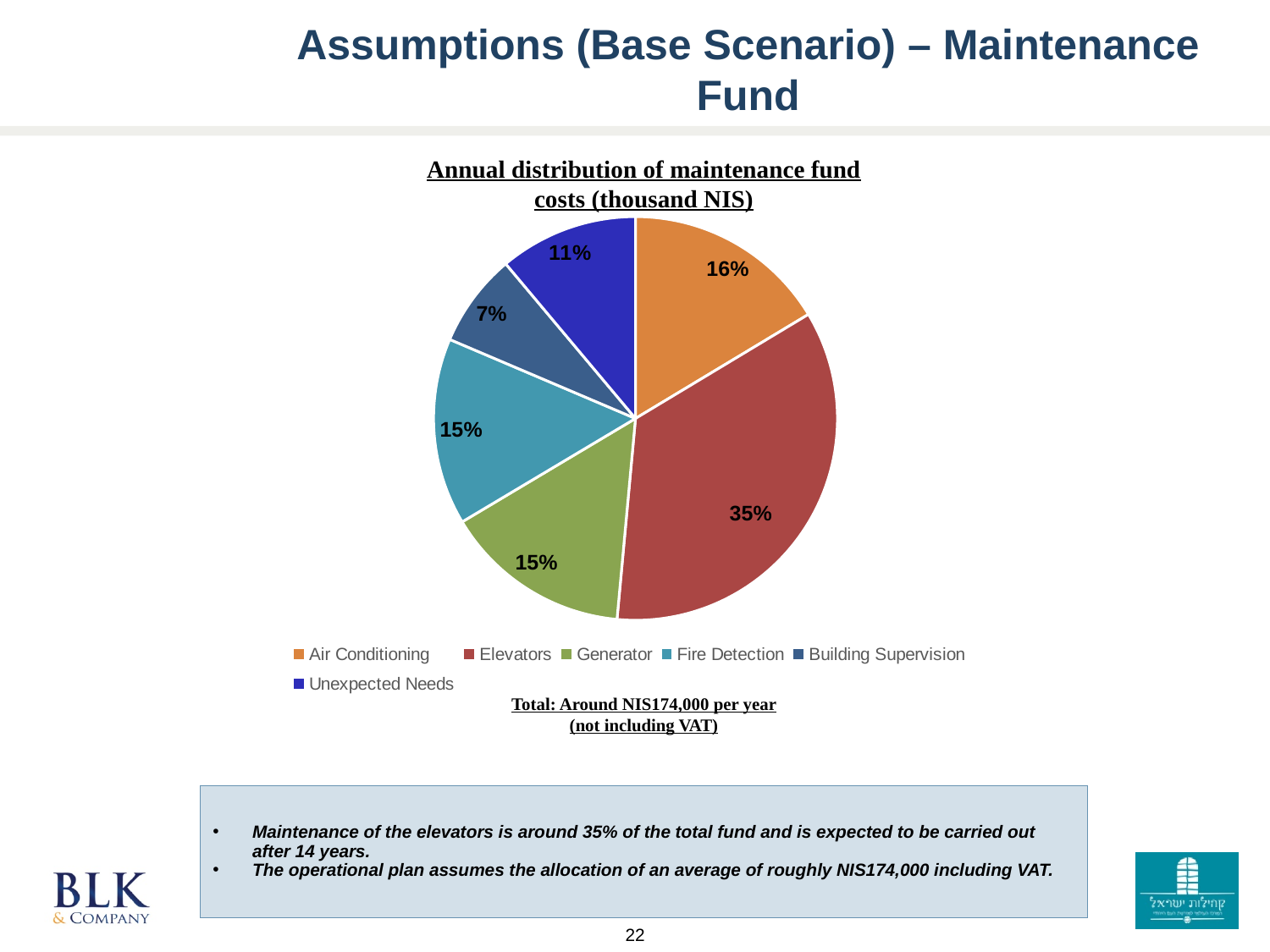
What share of the maintenance fund costs is allocated to Fire Detection? 15% What share of the maintenance fund costs is allocated to Unexpected Needs? 11% What is the title of the pie chart? Annual distribution of maintenance fund costs (thousand NIS) What share of the maintenance fund costs is allocated to Air Conditioning? 16% What type of chart is shown on the slide? Pie chart Which category has the smallest share of the maintenance fund costs? Building Supervision Which has a larger share, Unexpected Needs or Building Supervision? Unexpected Needs Which category has the largest share of the maintenance fund costs? Elevators What is the difference in percentage points between the Elevators share and the Air Conditioning share? 19 percentage points How many categories does the pie chart show? 6